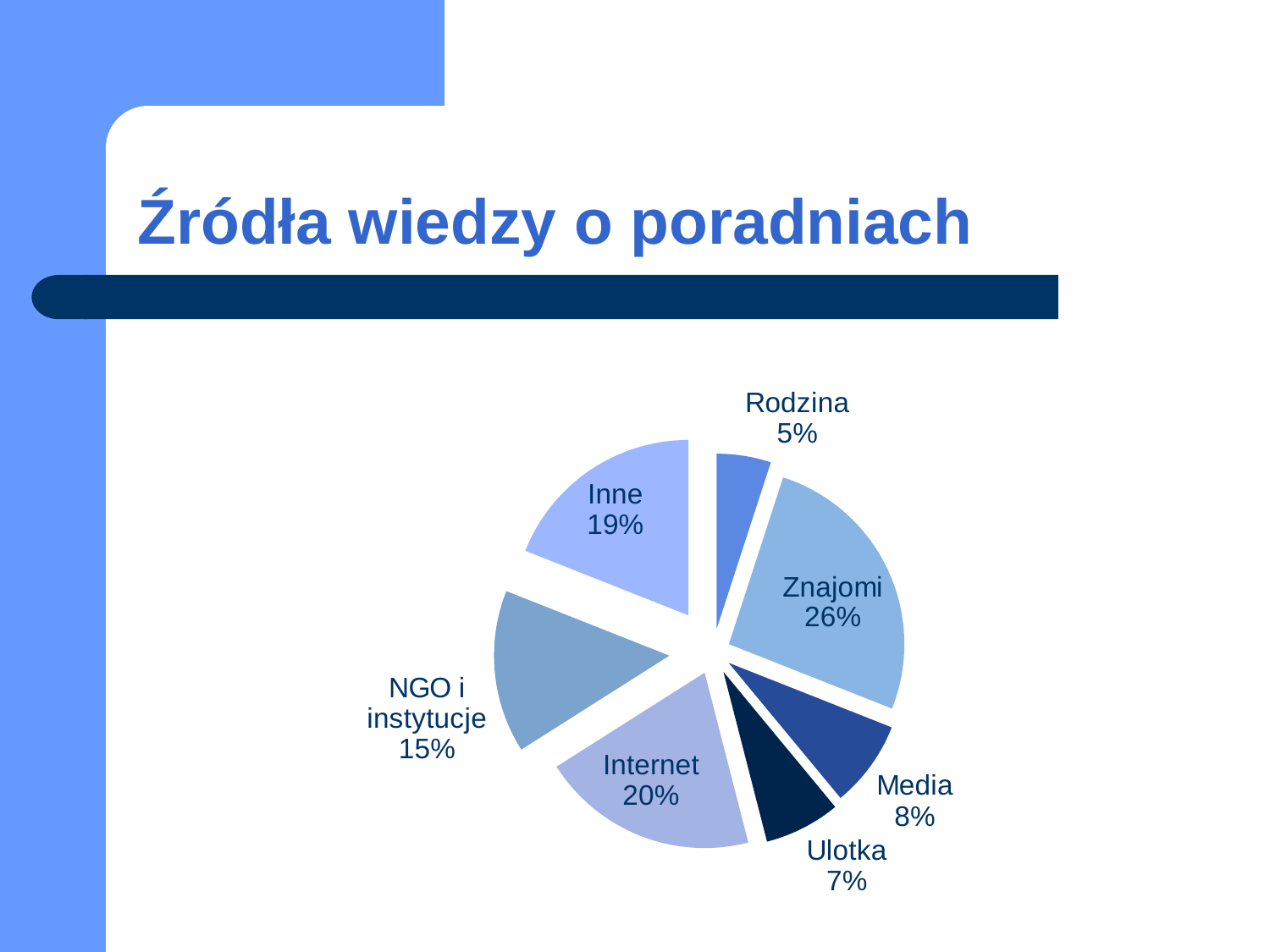
What share does Rodzina have in the pie chart? 5% What is the combined share of Media and Ulotka? 15% What share does Znajomi have in the pie chart? 26% Which category has the largest slice of the pie chart? Znajomi What share does NGO i instytucje have in the pie chart? 15% What is the difference in percentage points between Znajomi and Internet? 6 Which category has the smallest slice of the pie chart? Rodzina What share does Ulotka have in the pie chart? 7% What is the title of the slide containing the pie chart? Źródła wiedzy o poradniach Which is larger, the share for Inne or the share for NGO i instytucje? Inne How many categories are shown in the pie chart? 7 What kind of chart is shown on the slide? pie chart